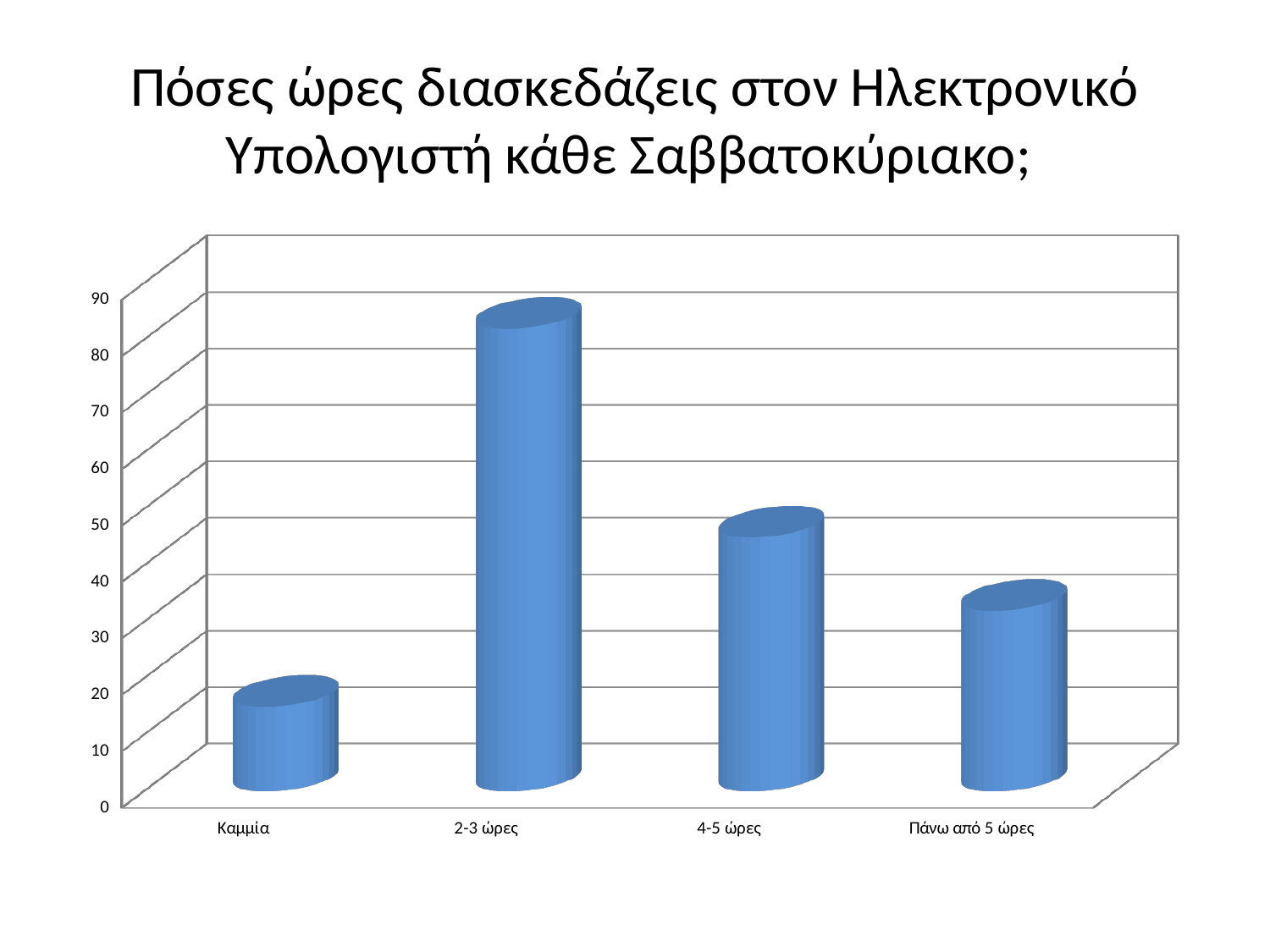
Which is larger, the value for Καμμία or the value for Πάνω από 5 ώρες? Πάνω από 5 ώρες Which is larger, the value for 4-5 ώρες or the value for Πάνω από 5 ώρες? 4-5 ώρες Is the value for Πάνω από 5 ώρες greater or less than 60? less What is the title of the chart on the slide? Πόσες ώρες διασκεδάζεις στον Ηλεκτρονικό Υπολογιστή κάθε Σαββατοκύριακο; Is the value for Καμμία greater or less than 30? less How many categories are shown on the x axis of the chart? 4 Which category has the highest value in the chart? 2-3 ώρες Is the value for 4-5 ώρες greater or less than 30? greater Do the values rise or fall from 2-3 ώρες to Πάνω από 5 ώρες along the x axis? fall What kind of chart is shown on the slide? bar chart Which category has the lowest value in the chart? Καμμία